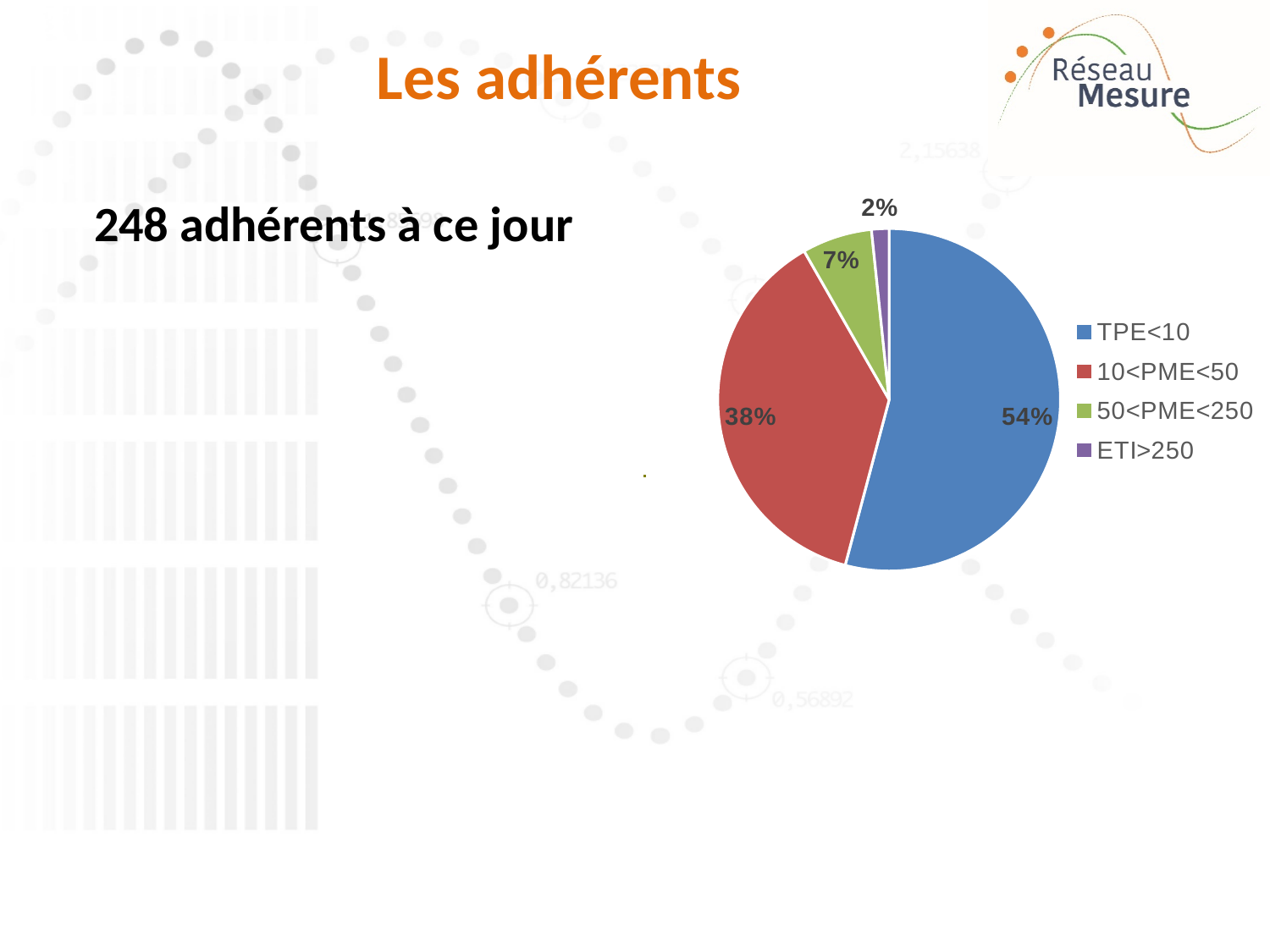
What is the difference in percentage points between the TPE<10 slice and the 10<PME<50 slice? 16 What colour is the slice for 10<PME<50? red What share of the pie does TPE<10 represent? 54% Which slice is larger, 50<PME<250 or ETI>250? 50<PME<250 What is the title of the slide containing the pie chart? Les adhérents Which category has the smallest slice of the pie? ETI>250 Which category has the largest slice of the pie? TPE<10 What kind of chart is shown on the slide? pie chart What share of the pie does 50<PME<250 represent? 7% What share of the pie does 10<PME<50 represent? 38% How many categories does the legend list? 4